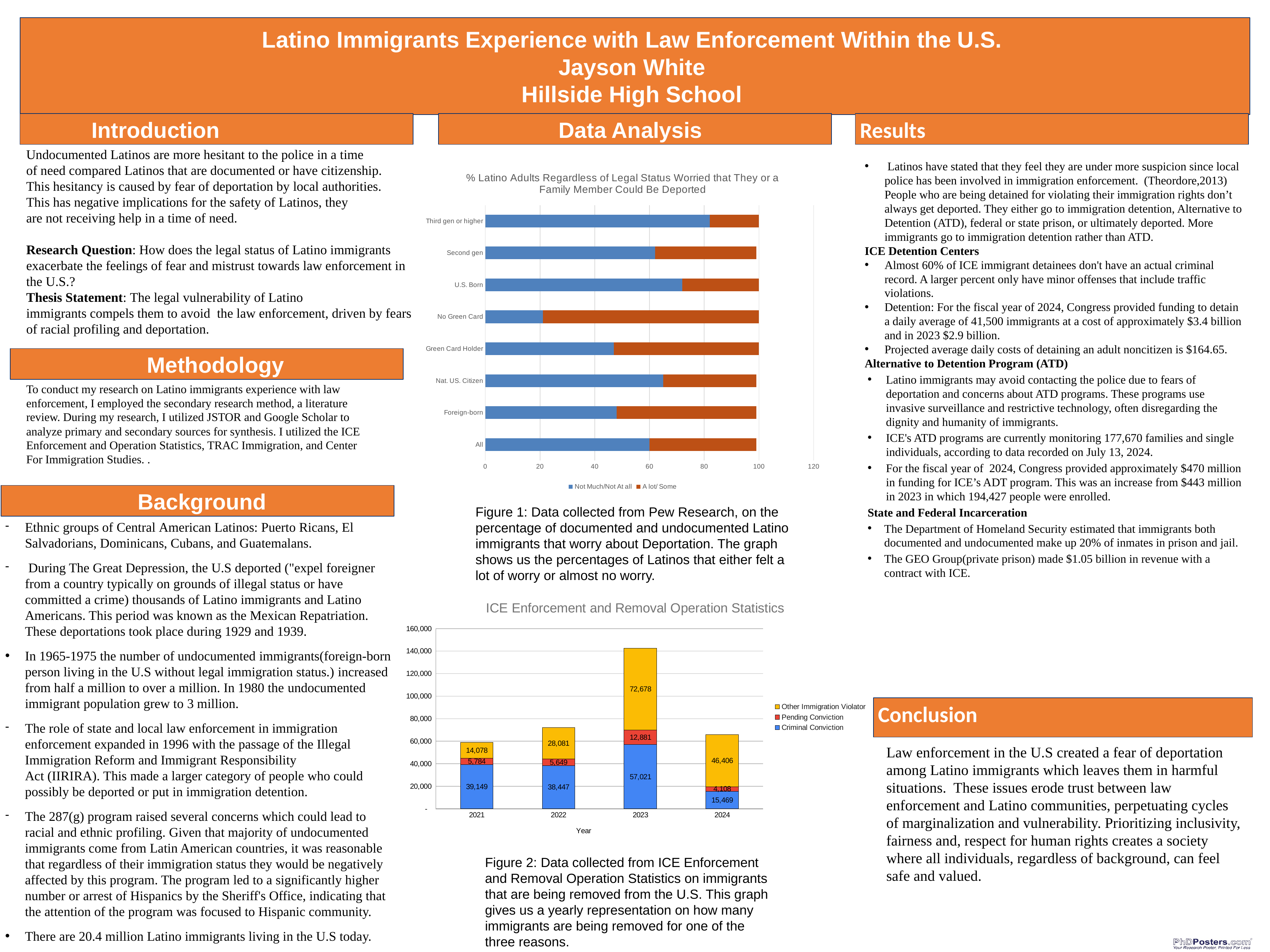
In the 'ICE Enforcement and Removal Operation Statistics' chart, which year has the highest Other Immigration Violator value? 2023 In the 'ICE Enforcement and Removal Operation Statistics' chart, how many series does the legend list? 3 In the 'ICE Enforcement and Removal Operation Statistics' chart, what is the Other Immigration Violator value for 2024? 46,406 In the 'ICE Enforcement and Removal Operation Statistics' chart, what is the Pending Conviction value for 2021? 5,784 In the '% Latino Adults Regardless of Legal Status Worried that They or a Family Member Could Be Deported' chart, how many categories are shown on the vertical axis? 8 In the 'ICE Enforcement and Removal Operation Statistics' chart, what is the total of the stacked bar for 2023? 142,580 In the 'ICE Enforcement and Removal Operation Statistics' chart, what is the Criminal Conviction value for 2023? 57,021 In the '% Latino Adults Regardless of Legal Status Worried that They or a Family Member Could Be Deported' chart, is the Not Much/Not At all value for No Green Card greater or less than 40? less In the 'ICE Enforcement and Removal Operation Statistics' chart, is the Criminal Conviction value for 2022 larger than the Criminal Conviction value for 2021? No In the 'ICE Enforcement and Removal Operation Statistics' chart, which year has the lowest Criminal Conviction value? 2024 What kind of chart is the '% Latino Adults Regardless of Legal Status Worried that They or a Family Member Could Be Deported' chart? Stacked bar chart In the 'ICE Enforcement and Removal Operation Statistics' chart, what is the difference between the Other Immigration Violator values for 2022 and 2021? 14,003